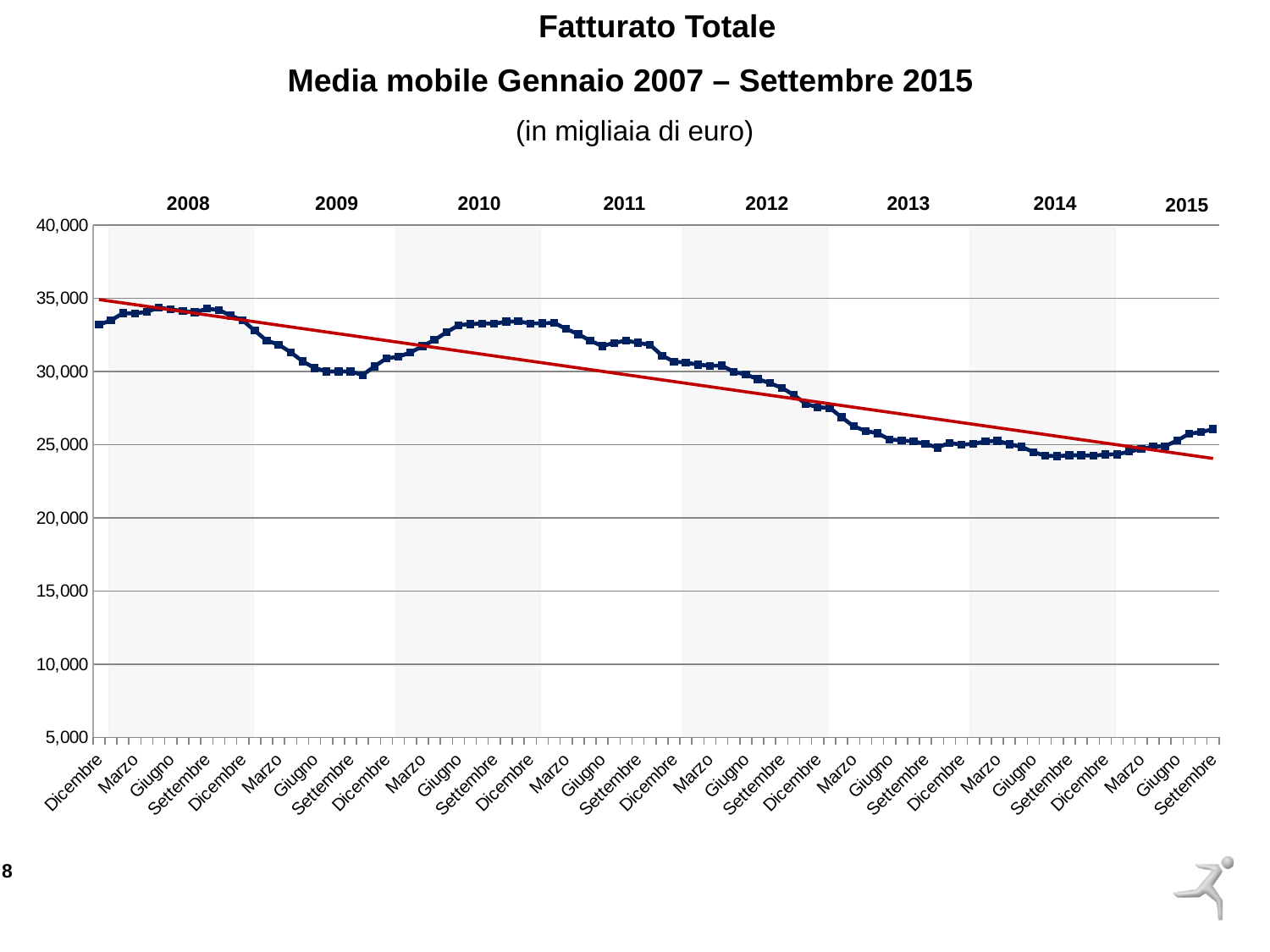
Is the value for Giugno 2013 greater or less than 30,000? less Is the value for Settembre 2014 greater or less than 25,000? less Is the value for Settembre 2015 greater or less than 25,000? greater What kind of chart is shown on the slide? line chart Overall, do the plotted values rise or fall from left to right across the chart? fall Does the red straight line on the chart slope upward or downward from left to right? downward What is the main title of the chart? Fatturato Totale How many year labels are shown along the top of the chart? 8 In what unit are the values on the chart expressed, according to the subtitle? in migliaia di euro